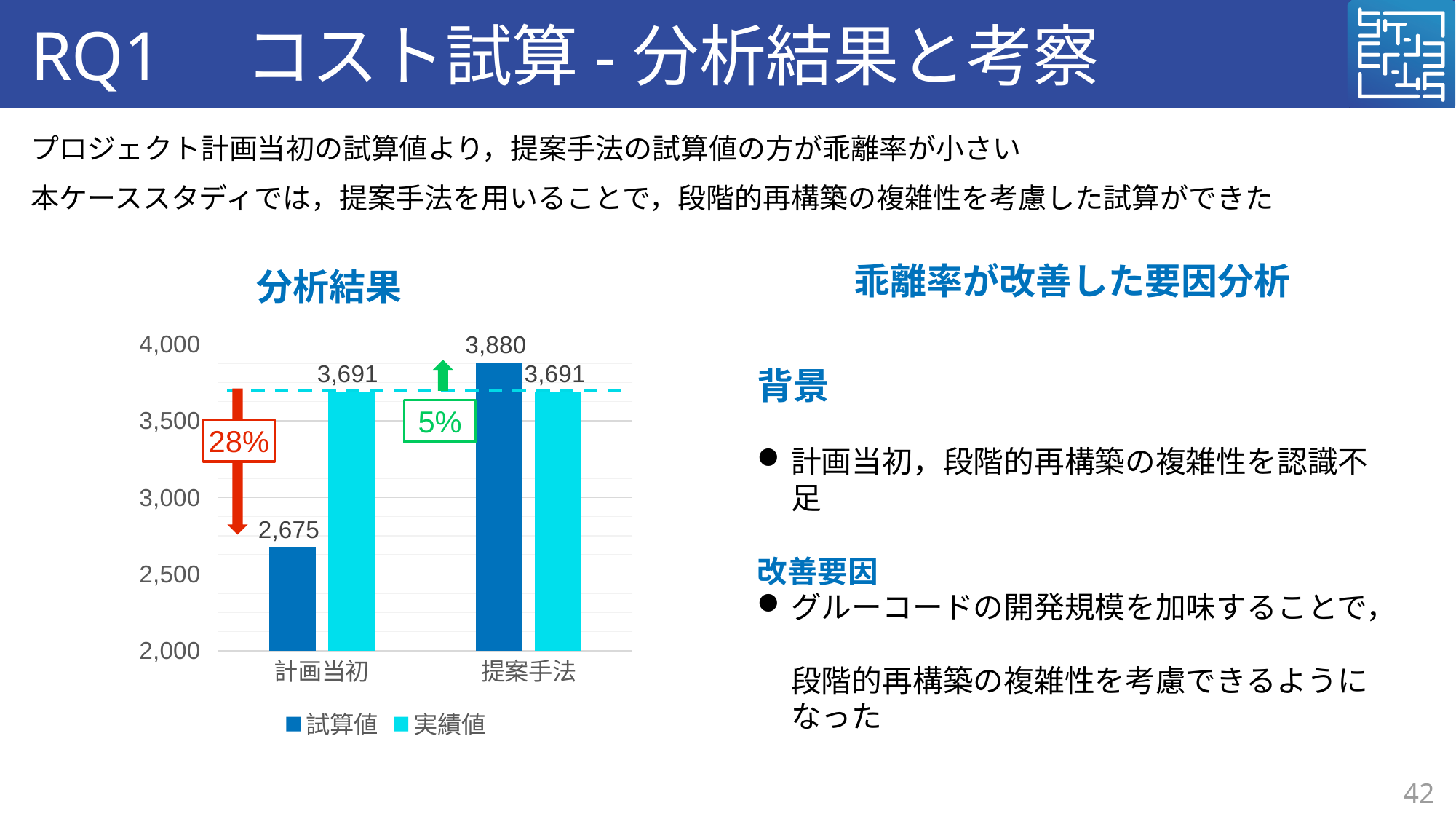
What is the 実績値 for 計画当初? 3,691 What is the difference between the 試算値 for 提案手法 and the 試算値 for 計画当初? 1,205 What is the 試算値 for 提案手法? 3,880 Which bar has the lowest value in the chart? 試算値 for 計画当初 What is the difference between the 実績値 and the 試算値 for 計画当初? 1,016 How many categories are shown on the x axis of the chart? 2 How many series does the chart legend list? 2 Which is larger for 提案手法, the 試算値 or the 実績値? 試算値 What kind of chart is shown under 分析結果? Bar chart Which bar has the highest value in the chart? 試算値 for 提案手法 What is the 試算値 for 計画当初? 2,675 What is the 実績値 for 提案手法? 3,691